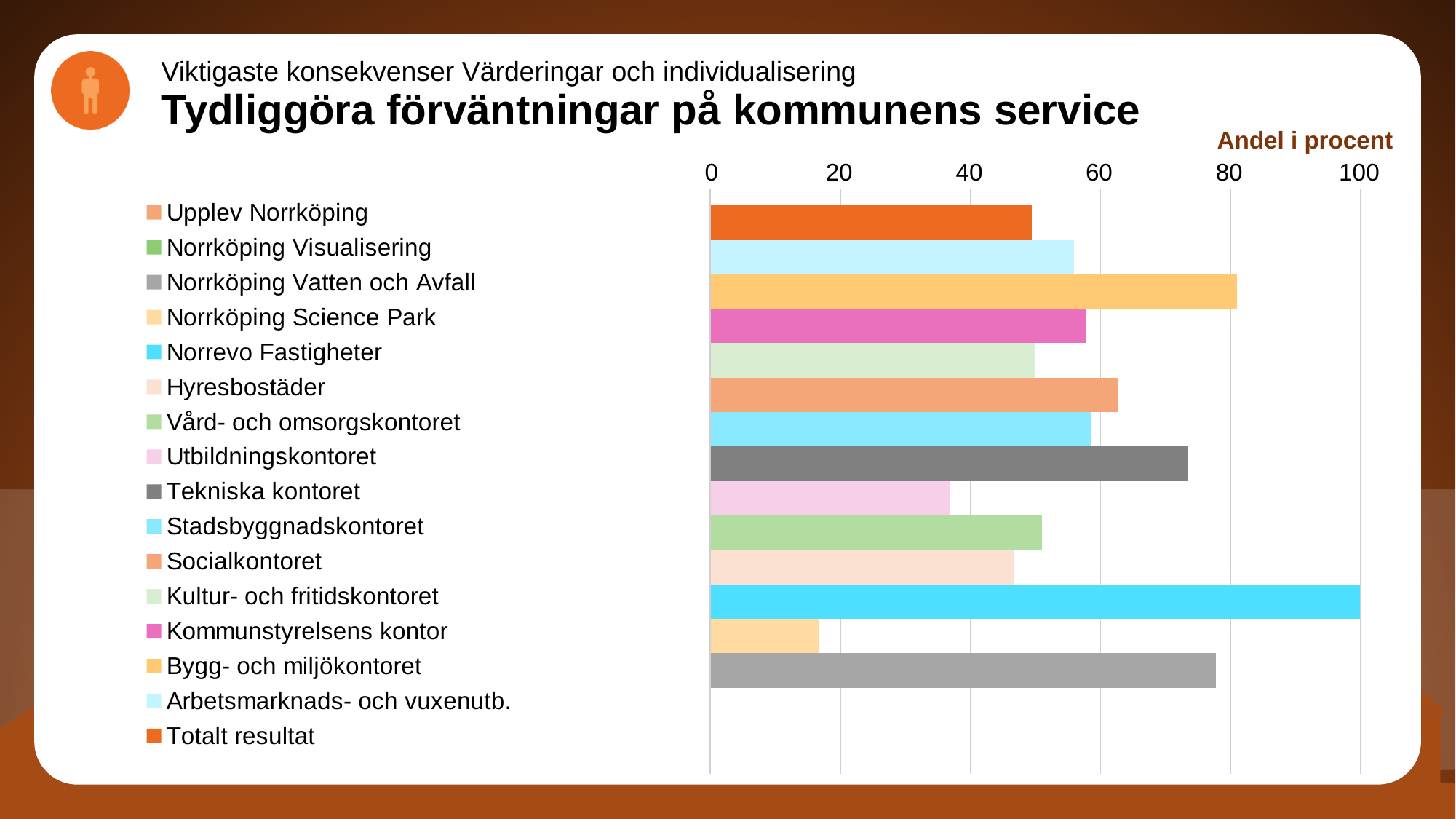
Which category has the highest value in the chart? Norrevo Fastigheter Is the value for Norrevo Fastigheter greater or less than 80? greater Is the value for Hyresbostäder greater or less than 60? less Is the value for Utbildningskontoret greater or less than 40? less How many entries does the chart legend list? 16 Which is larger, the value for Norrköping Vatten och Avfall or the value for Hyresbostäder? Norrköping Vatten och Avfall What label is shown above the horizontal axis of the chart? Andel i procent What kind of chart is shown on the slide? bar chart Which is larger, the value for Tekniska kontoret or the value for Utbildningskontoret? Tekniska kontoret